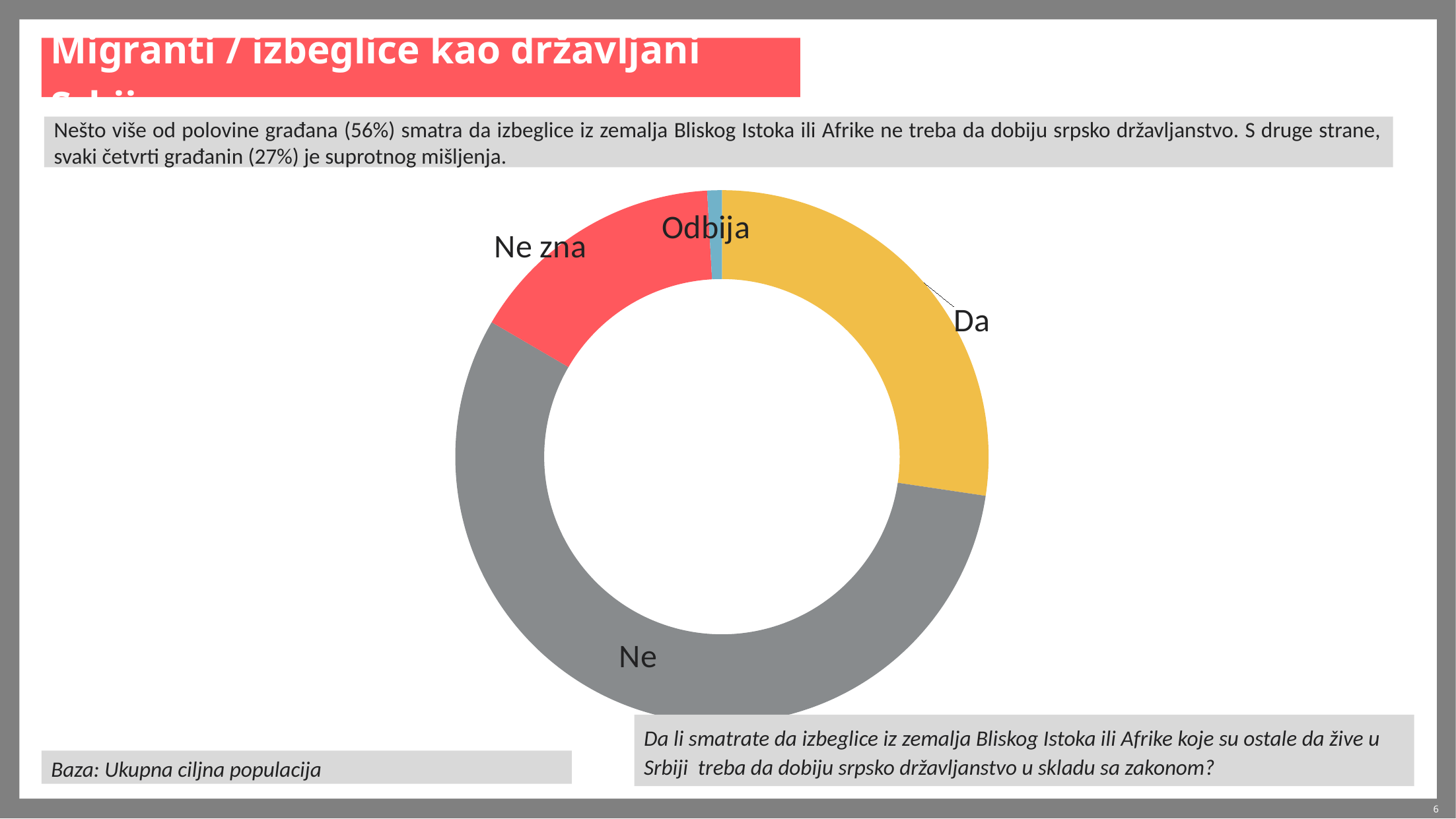
According to the slide, what share of citizens answered Ne (refugees should not get Serbian citizenship)? 56% Which slice is larger, Da or Ne zna? Da Which category has the smallest slice in the doughnut chart? Odbija Which category has the largest slice in the doughnut chart? Ne By how many percentage points does the Ne share (56%) exceed the Da share (27%)? 29 percentage points What base (Baza) is stated for the chart on the slide? Ukupna ciljna populacija What kind of chart is shown on the slide? Doughnut chart What colour is the Da slice in the doughnut chart? Yellow Which slice is larger, Ne or Da? Ne How many slices does the doughnut chart have? 4 According to the slide, what share of citizens answered Da (refugees should get Serbian citizenship)? 27%